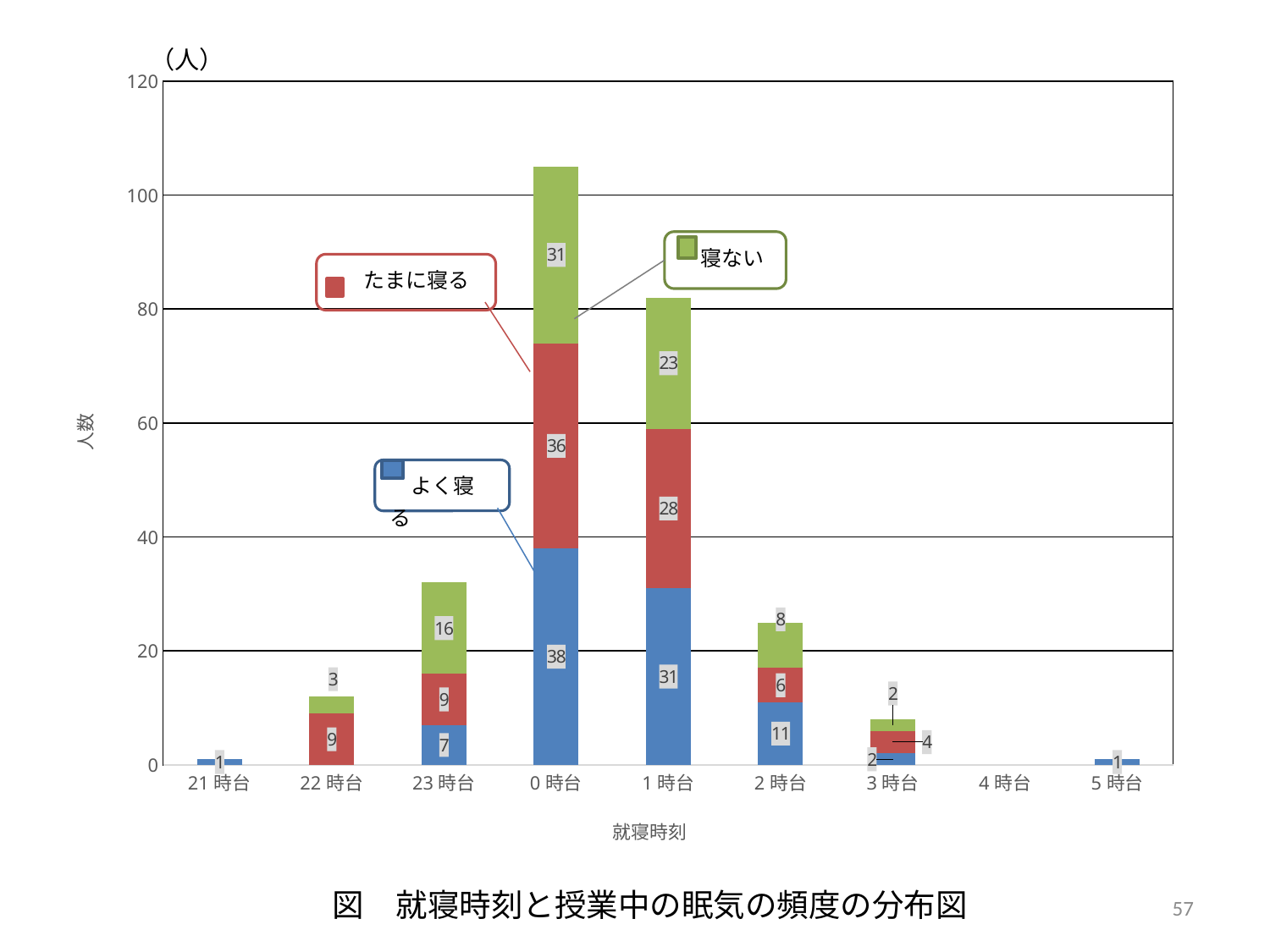
What is the difference between the よく寝る values for 0 時台 and 1 時台? 7 How many series does the chart show (as labelled in the callouts)? 3 Which is larger: the 寝ない value for 23 時台 or the 寝ない value for 2 時台? 23 時台 What is the total of the stacked bar for 0 時台? 105 What is the value of たまに寝る for 23 時台? 9 What kind of chart is shown on the slide? stacked bar chart Which bedtime category has the tallest stacked bar? 0 時台 What is the value of よく寝る for 0 時台? 38 Is the total stacked bar for 1 時台 greater or less than 80? greater What is the total of the stacked bar for 1 時台? 82 What is the value of 寝ない for 1 時台? 23 How many bedtime categories are shown on the x axis? 9